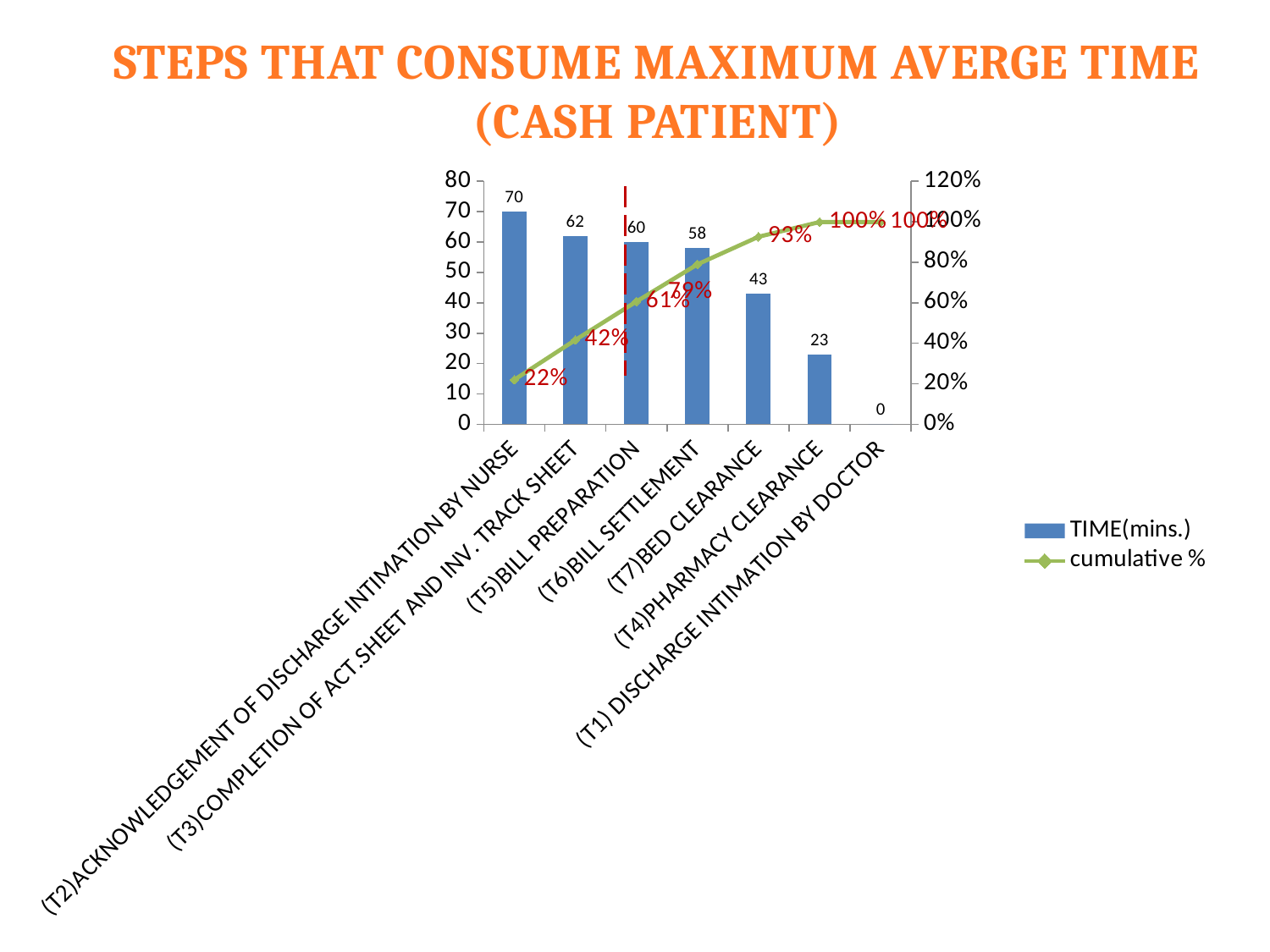
What is the TIME(mins.) value for (T2)ACKNOWLEDGEMENT OF DISCHARGE INTIMATION BY NURSE? 70 What is the difference in TIME(mins.) between (T3)COMPLETION OF ACT.SHEET AND INV. TRACK SHEET and (T6)BILL SETTLEMENT? 4 How many series does the legend list? 2 What is the cumulative % value at (T7)BED CLEARANCE? 93% Which step has the highest TIME(mins.) value? (T2)ACKNOWLEDGEMENT OF DISCHARGE INTIMATION BY NURSE Which step has the lowest TIME(mins.) value? (T1) DISCHARGE INTIMATION BY DOCTOR What is the TIME(mins.) value for (T4)PHARMACY CLEARANCE? 23 How many steps (categories) are shown on the x axis? 7 What is the cumulative % value at (T3)COMPLETION OF ACT.SHEET AND INV. TRACK SHEET? 42% What is the TIME(mins.) value for (T7)BED CLEARANCE? 43 Does the cumulative % line rise or fall from left to right along the x axis? rise Which has a larger TIME(mins.) value, (T5)BILL PREPARATION or (T7)BED CLEARANCE? (T5)BILL PREPARATION